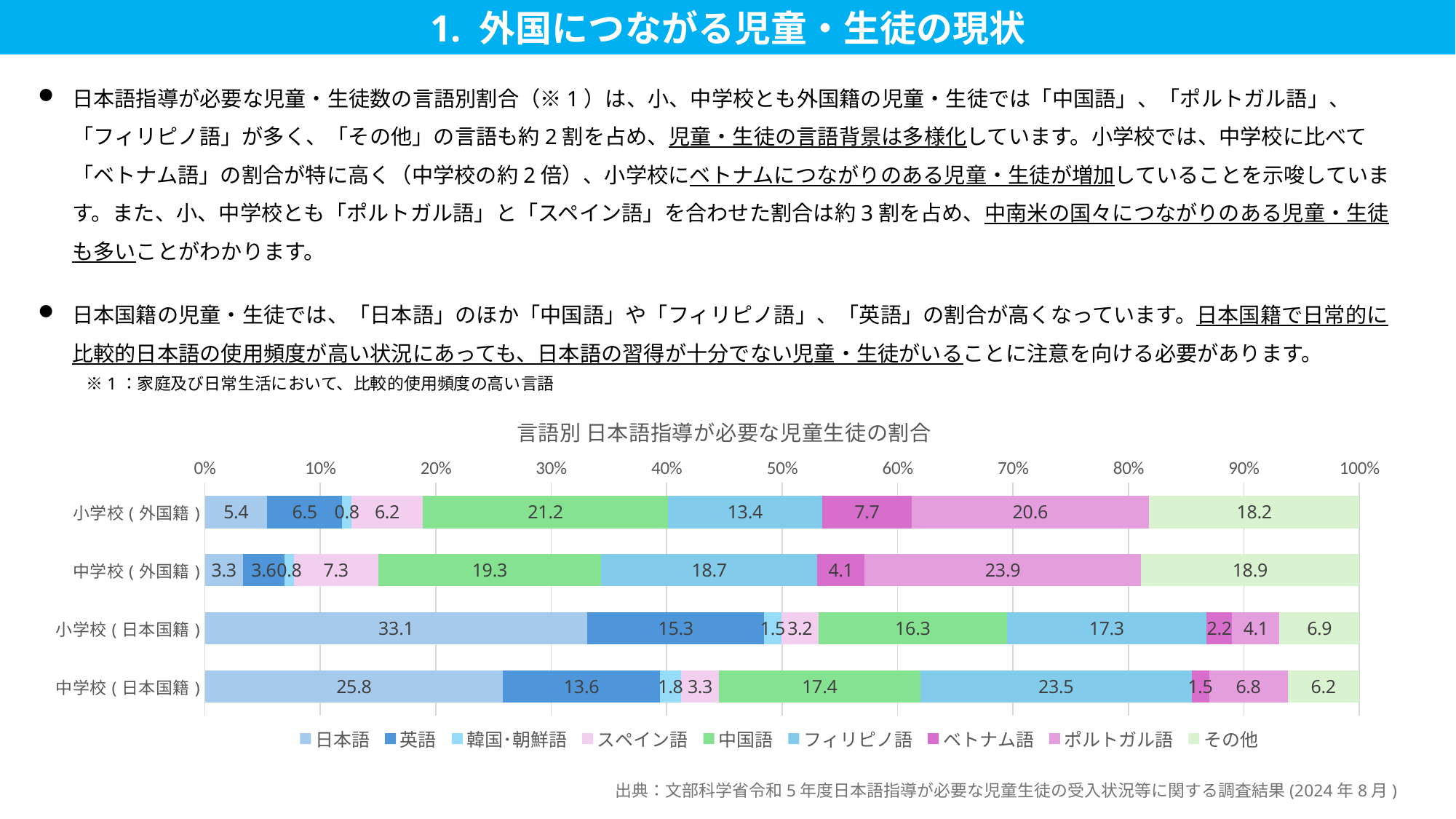
What is the value for ポルトガル語 in the 中学校(外国籍) bar? 23.9 How many categories (bars) are plotted on the chart? 4 What is the value for 中国語 in the 小学校(外国籍) bar? 21.2 How many series does the legend list? 9 What is the difference between the ベトナム語 values for 小学校(外国籍) and 中学校(外国籍)? 3.6 Which language has the smallest share in the 小学校(外国籍) bar? 韓国･朝鮮語 What kind of chart is shown on the slide? Stacked bar chart What is the value for フィリピノ語 in the 中学校(日本国籍) bar? 23.5 What is the value for 日本語 in the 小学校(日本国籍) bar? 33.1 What is the title of the chart? 言語別 日本語指導が必要な児童生徒の割合 Which is larger: the 英語 value for 小学校(日本国籍) or for 中学校(日本国籍)? 小学校(日本国籍) Which language has the largest share in the 中学校(外国籍) bar? ポルトガル語